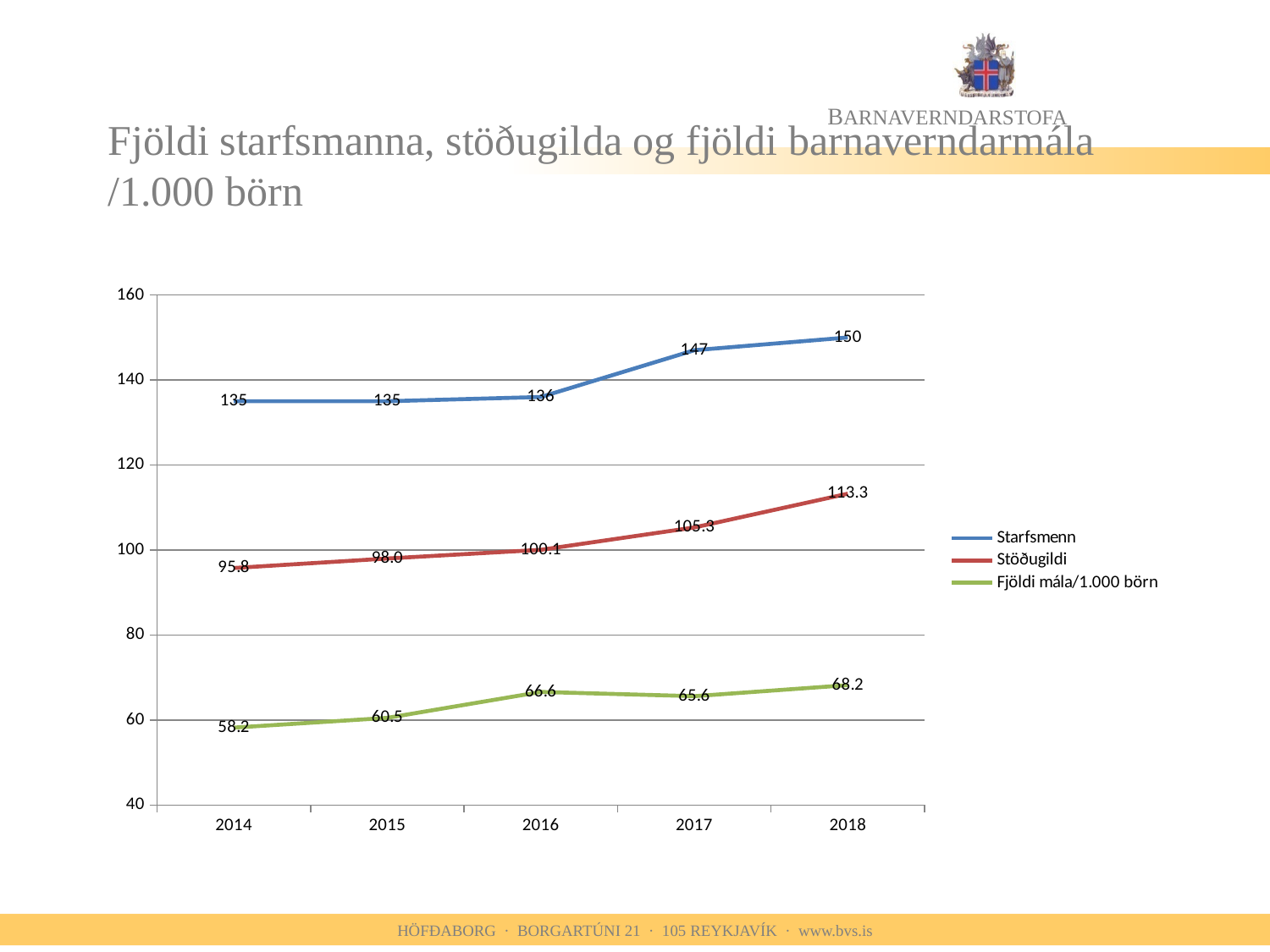
How many years are shown on the x axis? 5 What is the value for Stöðugildi in 2016? 100.1 How many series does the legend list? 3 What is the difference between the Starfsmenn values for 2018 and 2014? 15 In which year is the Stöðugildi series highest? 2018 What kind of chart is shown on the slide? line chart What is the value for Starfsmenn in 2018? 150 In which year is the Fjöldi mála/1.000 börn series lowest? 2014 What is the difference between the Stöðugildi values for 2018 and 2017? 8.0 What is the value for Fjöldi mála/1.000 börn in 2014? 58.2 Does the Stöðugildi series rise or fall from 2014 to 2018? rise Which is larger, the Fjöldi mála/1.000 börn value for 2016 or for 2017? 2016